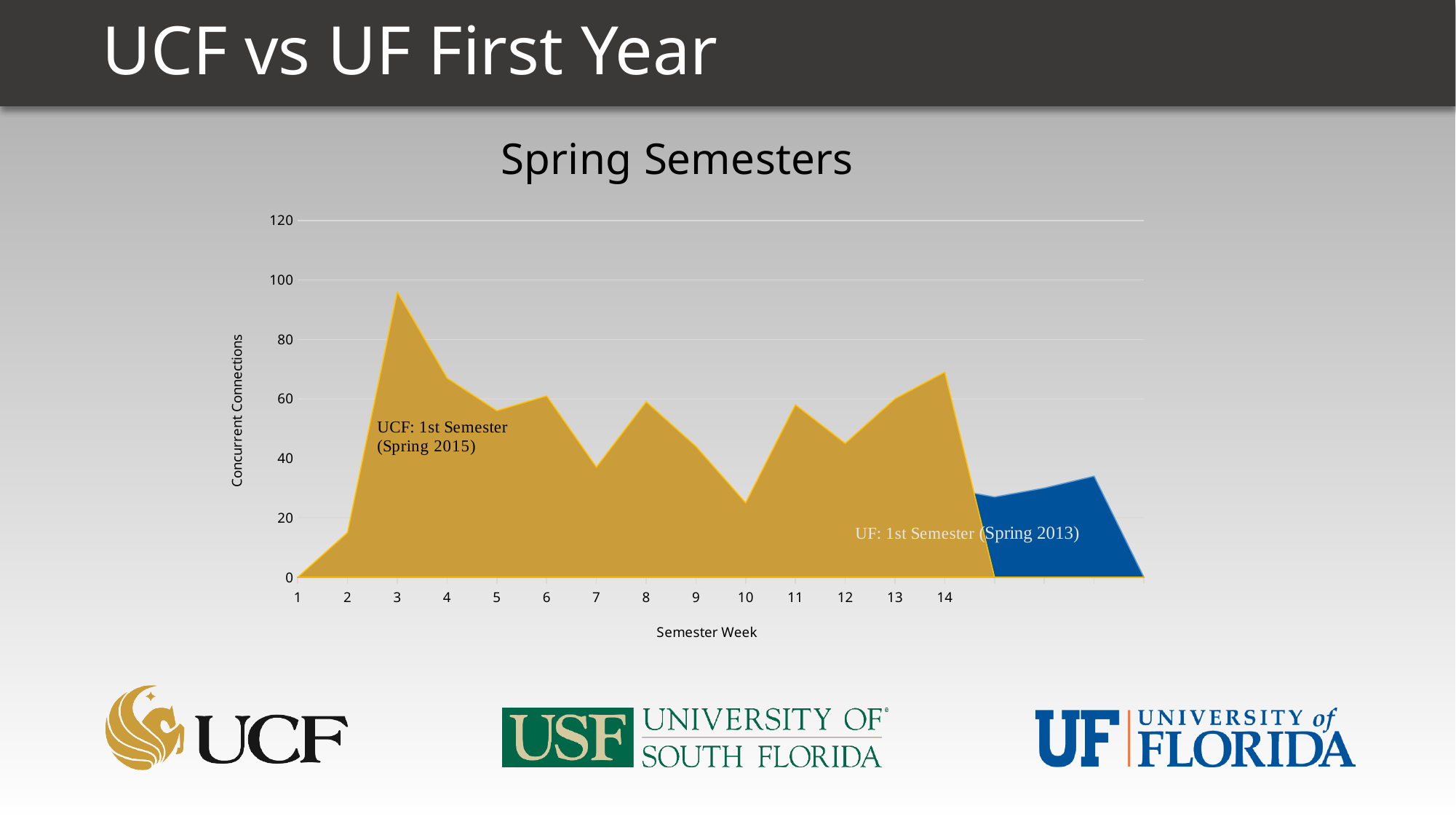
For UCF: 1st Semester (Spring 2015), which is larger: the value in week 3 or the value in week 7? Week 3 How many data series are plotted in the chart? 2 How many semester weeks are labeled on the x axis of the chart? 14 Does the UCF: 1st Semester (Spring 2015) series rise or fall from week 3 to week 4? Fall What is the label of the vertical axis of the chart? Concurrent Connections Is the value for UCF: 1st Semester (Spring 2015) in week 10 greater or less than 40? less Is the highest value of the UF: 1st Semester (Spring 2013) series greater or less than 60? less Is the value for UCF: 1st Semester (Spring 2015) in week 3 greater or less than 80? greater In which semester week does the UCF: 1st Semester (Spring 2015) series reach its highest value? Week 3 What is the title of the chart? Spring Semesters What kind of chart is shown on the slide? Area chart